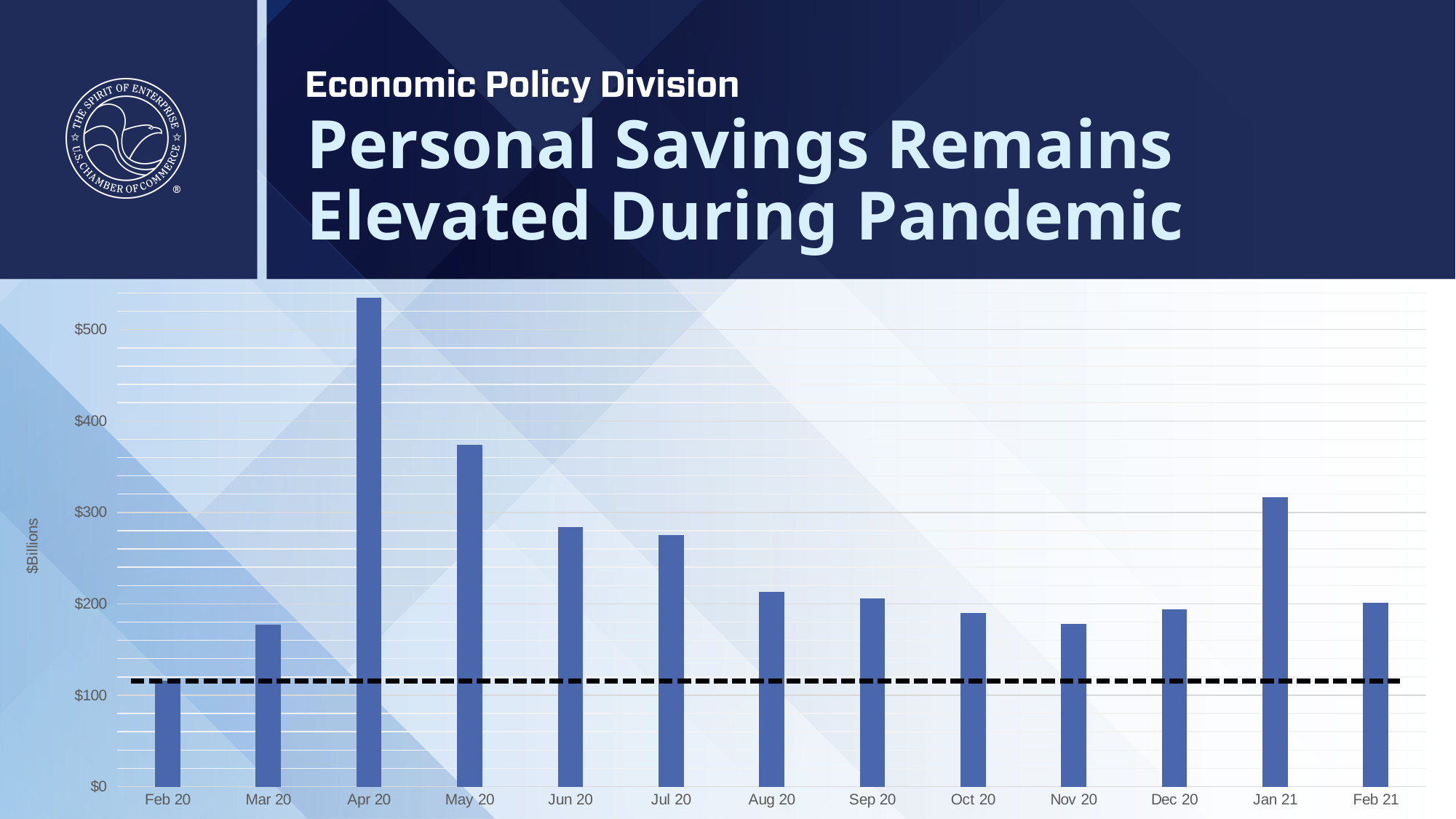
Is the value for May 20 greater or less than $400? less What kind of chart is shown on the slide? Bar chart Which is larger, the value for Apr 20 or the value for May 20? Apr 20 Which is larger, the value for Jan 21 or the value for Feb 21? Jan 21 Is the value for Apr 20 greater or less than $500? greater Is the value for Nov 20 greater or less than $200? less Which month has the lowest personal savings value in the chart? Feb 20 Which month has the highest personal savings value in the chart? Apr 20 Do the values rise or fall from Apr 20 through Nov 20? Fall How many months are plotted on the x axis of the chart? 13 What is the label on the y axis of the chart? $Billions